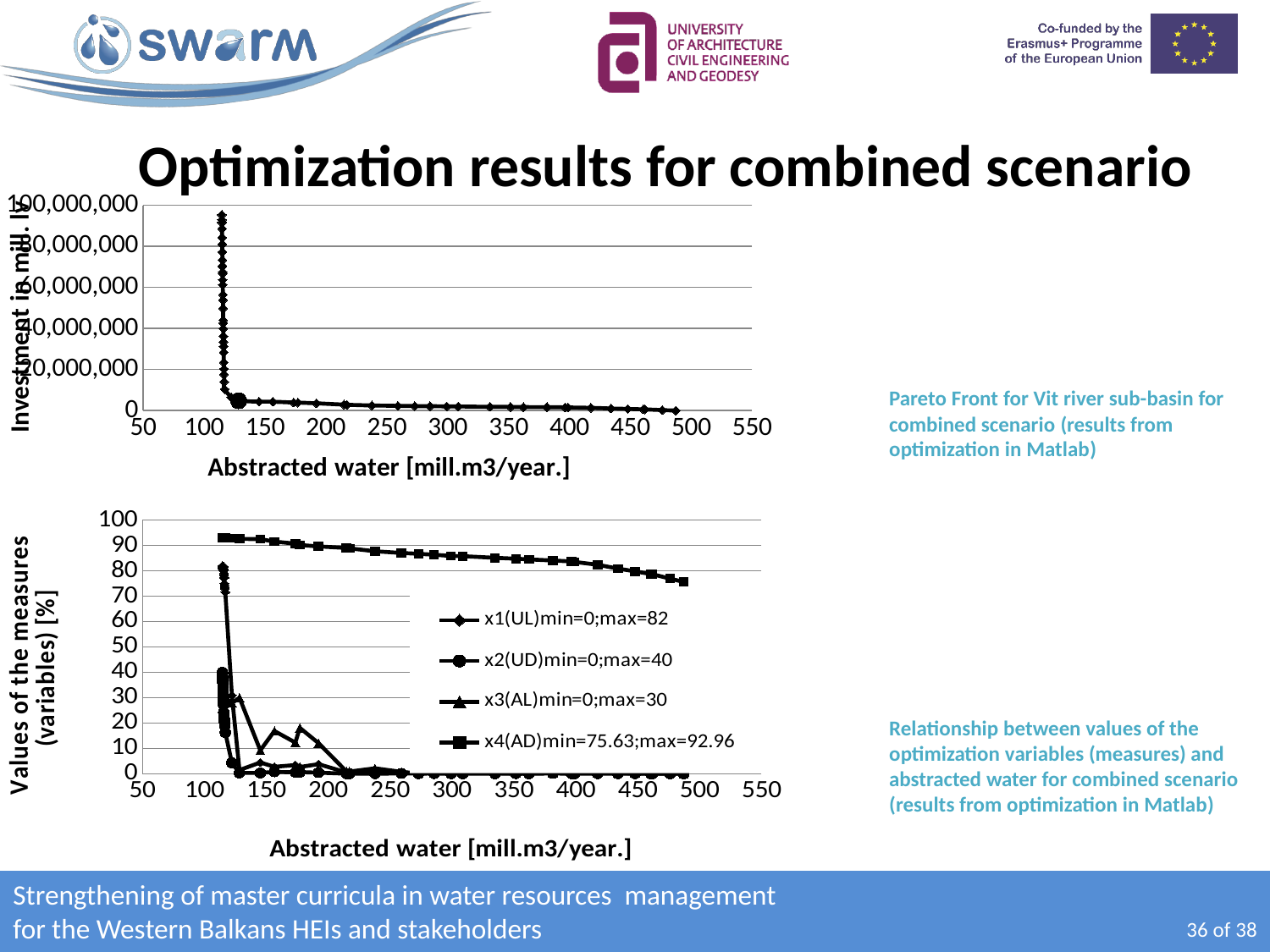
In the bottom chart, at 300 mill.m3/year, which series has the larger value: x4(AD) or x1(UL)? x4(AD) In the bottom chart, is the value of the x1(UL) series at 400 mill.m3/year greater or less than 10? less In the bottom chart, which series is plotted with square markers? x4(AD)min=75.63;max=92.96 In the top chart, do the investment values rise or fall as abstracted water increases beyond 150 mill.m3/year? fall In the top chart, what is the title of the x axis? Abstracted water [mill.m3/year.] In the bottom chart, is the value of the x4(AD) series at 300 mill.m3/year greater or less than 70? greater What kind of chart is the bottom chart? line chart How many series does the legend of the bottom chart list? 4 In the top chart, what is the title of the y axis? Investment in mill. lv In the bottom chart, do the values of the x4(AD) series rise or fall as abstracted water increases? fall In the top chart, is the investment at 400 mill.m3/year of abstracted water greater or less than 20,000,000? less